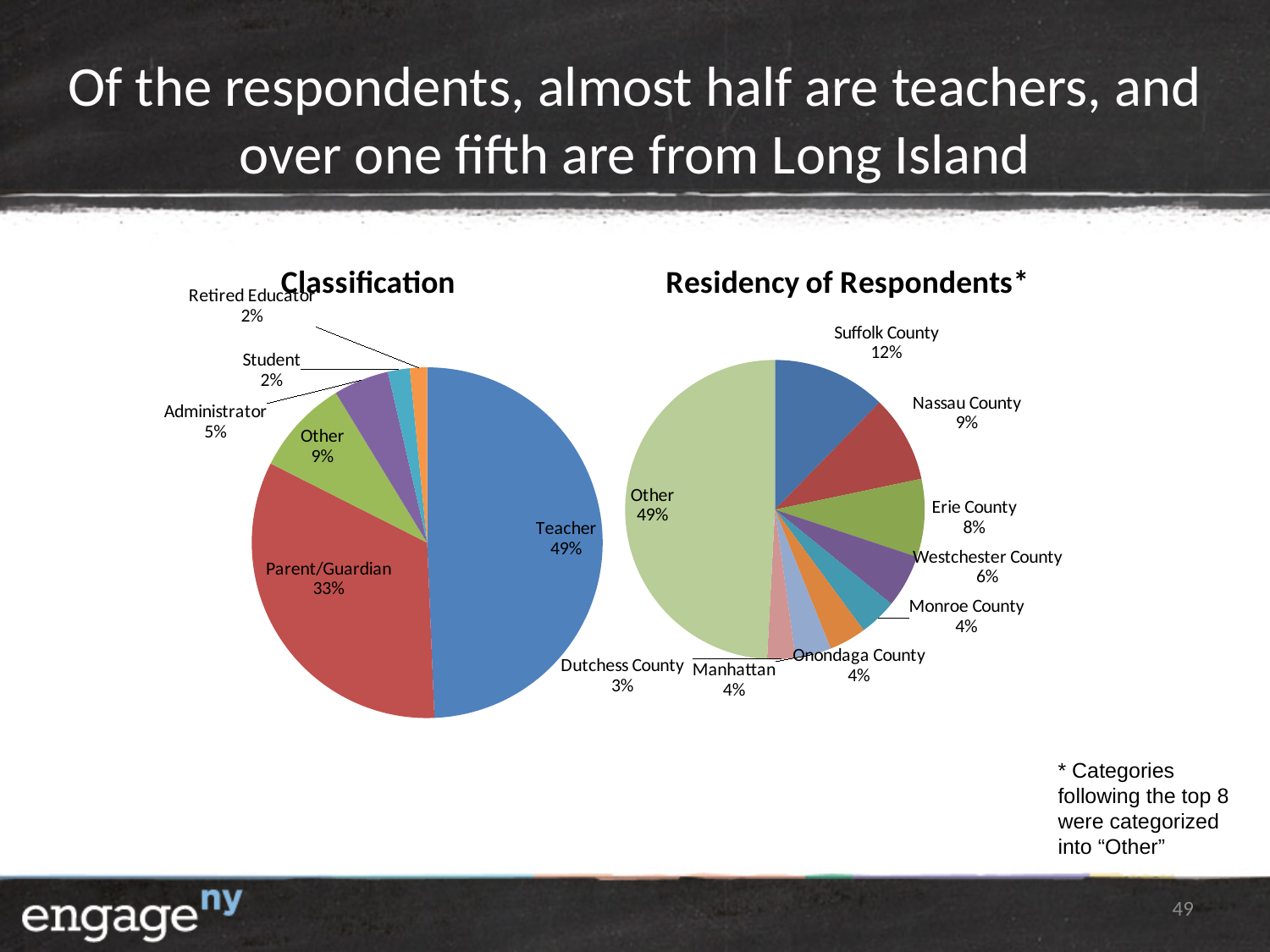
In the Classification chart, what share of respondents are Parent/Guardian? 33% In the Classification chart, what percentage of respondents are teachers? 49% In the Residency of Respondents chart, which named county has the smallest share? Dutchess County How many categories are shown in the Classification chart? 6 In the Classification chart, what percentage are Administrators? 5% In the Classification chart, which category has the largest share? Teacher What type of chart is the Residency of Respondents chart? Pie chart In the Residency of Respondents chart, which is larger, Nassau County or Westchester County? Nassau County In the Residency of Respondents chart, what percentage are from Erie County? 8% In the Residency of Respondents chart, what percentage of respondents are from Suffolk County? 12% How many slices are in the Residency of Respondents chart? 9 In the Classification chart, what is the difference between the Teacher and Parent/Guardian shares? 16%